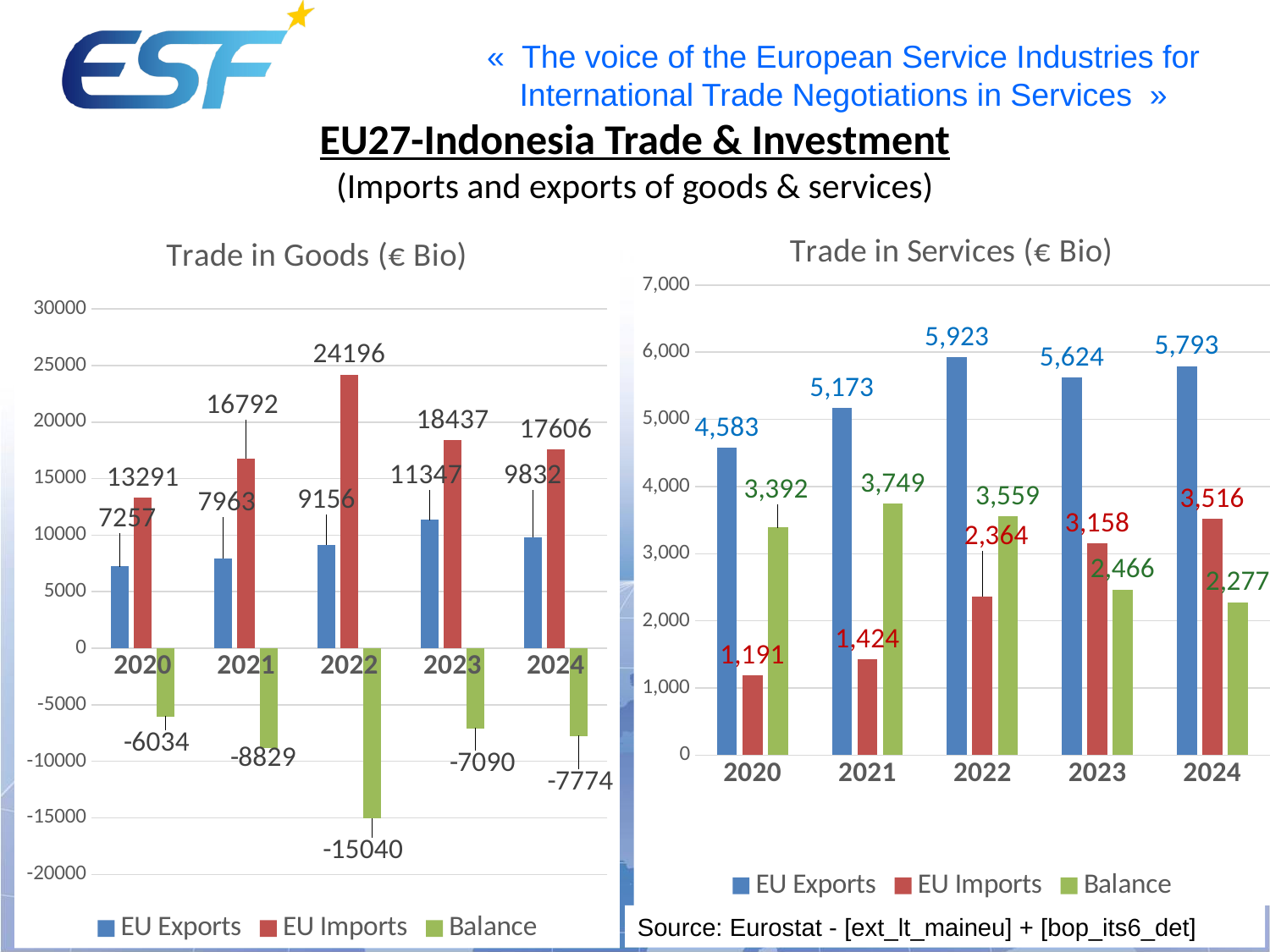
In the Trade in Services chart, which year has the highest EU Exports value? 2022 How many years are shown on the x axis of the Trade in Services chart? 5 In the Trade in Services chart, do the EU Imports values rise or fall from 2020 to 2024? Rise In the Trade in Services chart, which year has the lowest Balance value? 2024 In the Trade in Goods chart, which year has the highest EU Exports value? 2023 In the Trade in Services chart, what is the value of EU Imports in 2020? 1,191 In the Trade in Goods chart, what is the difference between EU Imports and EU Exports in 2024? 7774 In the Trade in Goods chart, what is the Balance value for 2021? -8829 In the Trade in Services chart, is EU Exports in 2021 larger than EU Exports in 2020? Yes What type of chart is the Trade in Goods chart? Bar chart How many series does the legend of the Trade in Goods chart list? 3 In the Trade in Goods chart, what is the value of EU Imports in 2022? 24196